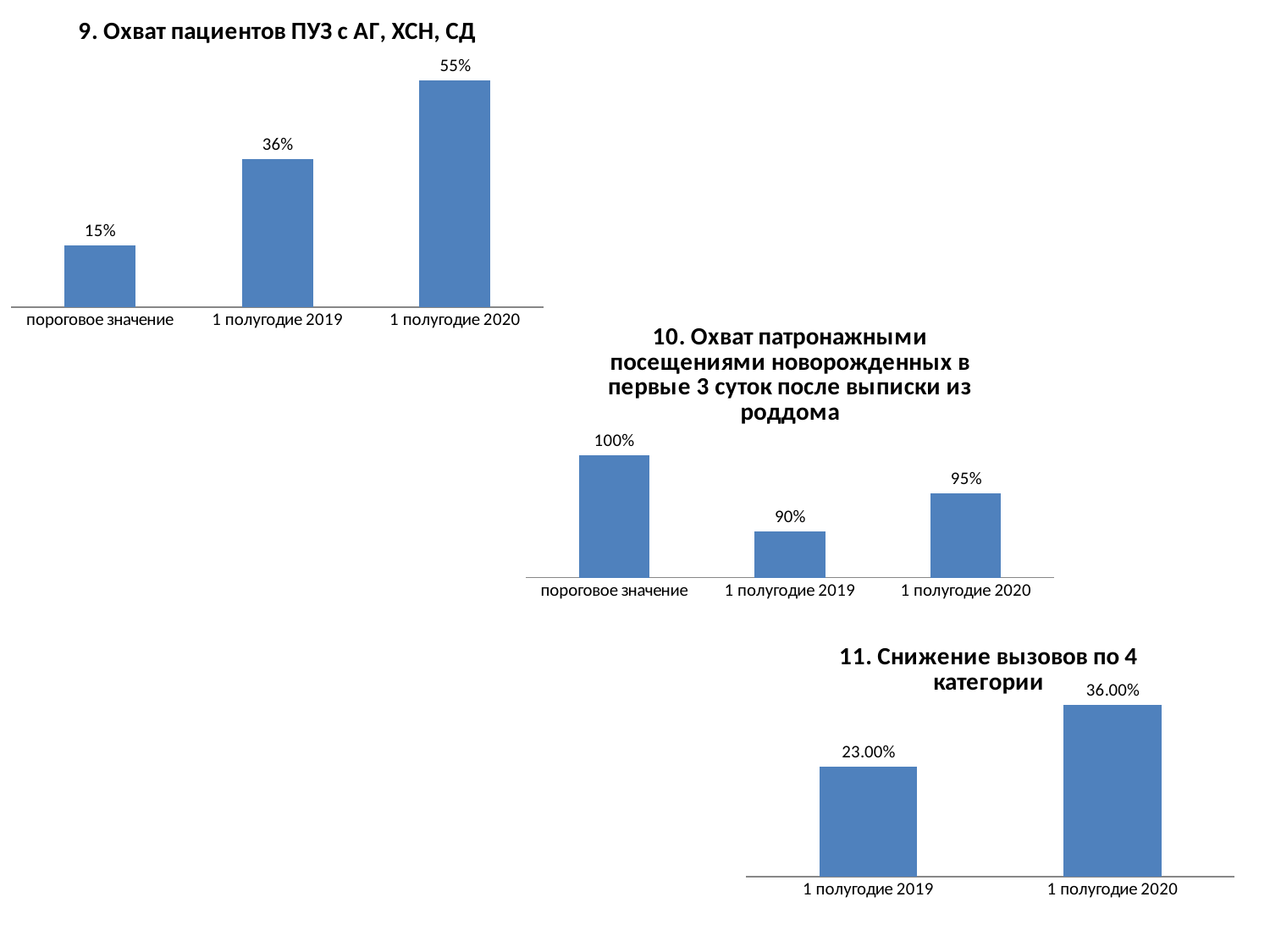
In the chart titled "11. Снижение вызовов по 4 категории", which category has the higher value, "1 полугодие 2019" or "1 полугодие 2020"? 1 полугодие 2020 In the chart titled "10. Охват патронажными посещениями новорожденных в первые 3 суток после выписки из роддома", which category has the lowest value? 1 полугодие 2019 In the chart titled "9. Охват пациентов ПУЗ с АГ, ХСН, СД", do the values rise or fall from left to right? rise In the chart titled "10. Охват патронажными посещениями новорожденных в первые 3 суток после выписки из роддома", what is the difference between "пороговое значение" and "1 полугодие 2019"? 10% In the chart titled "10. Охват патронажными посещениями новорожденных в первые 3 суток после выписки из роддома", how many categories are shown? 3 In the chart titled "9. Охват пациентов ПУЗ с АГ, ХСН, СД", what is the difference between the values for "1 полугодие 2020" and "1 полугодие 2019"? 19% In the chart titled "10. Охват патронажными посещениями новорожденных в первые 3 суток после выписки из роддома", what is the value for "1 полугодие 2020"? 95% How many charts are shown on the slide? 3 In the chart titled "11. Снижение вызовов по 4 категории", what is the value for "1 полугодие 2019"? 23.00% In the chart titled "9. Охват пациентов ПУЗ с АГ, ХСН, СД", what is the value for "пороговое значение"? 15% What kind of chart is the chart titled "11. Снижение вызовов по 4 категории"? bar chart In the chart titled "9. Охват пациентов ПУЗ с АГ, ХСН, СД", what is the value for "1 полугодие 2020"? 55%